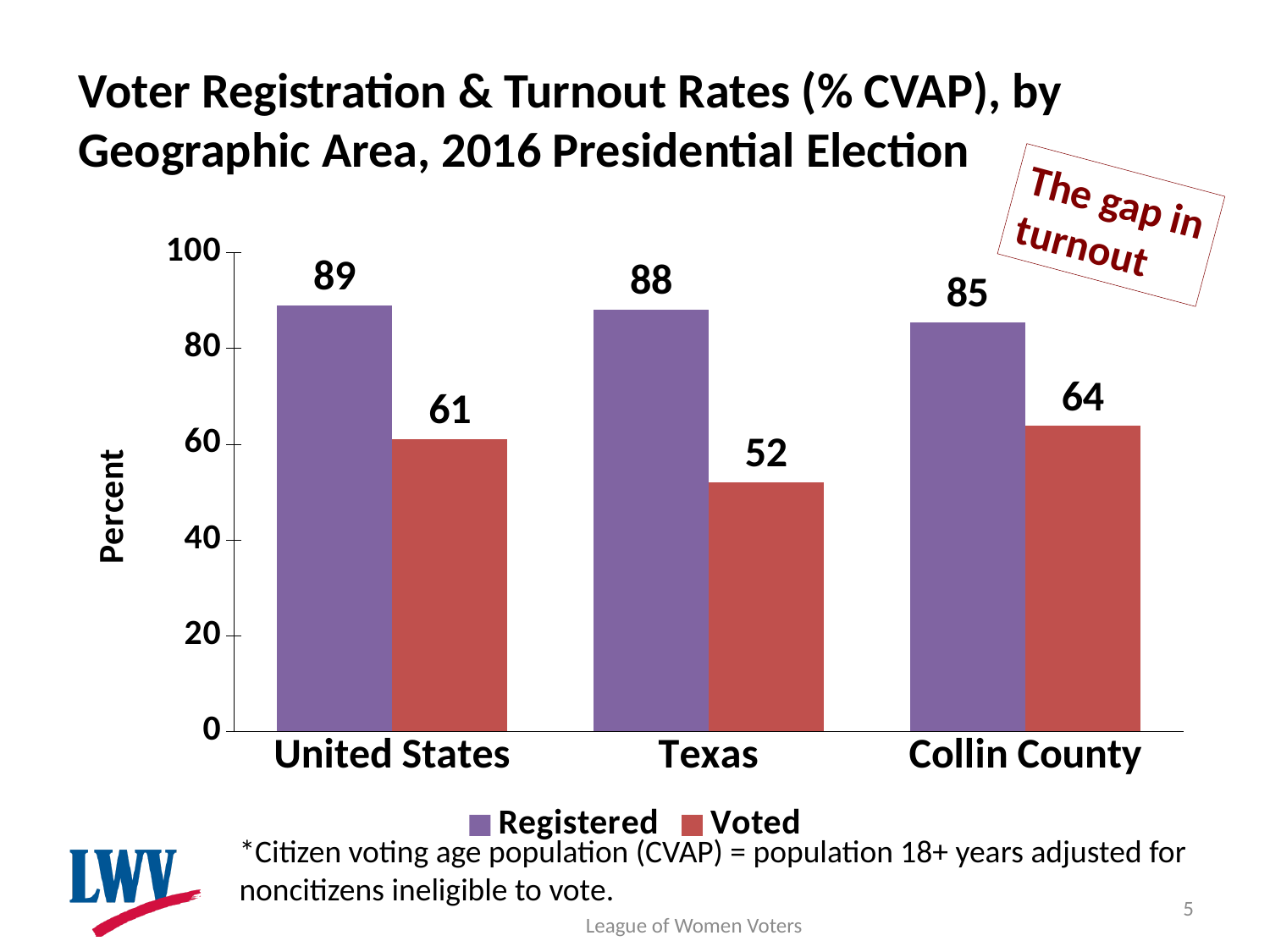
Which geographic area has the highest Registered value? United States What is the Voted value for the United States? 61 What is the difference between the Voted values for Collin County and the United States? 3 What is the difference between the Registered and Voted values for Texas? 36 How many geographic areas are shown on the x axis? 3 What is the Voted value for Collin County? 64 Which geographic area has the lowest Voted value? Texas What kind of chart is shown on the slide? Bar chart What is the label on the y axis? Percent How many series does the legend list? 2 Which is larger, the Voted value for Collin County or the Voted value for Texas? Collin County What is the Registered value for Texas? 88